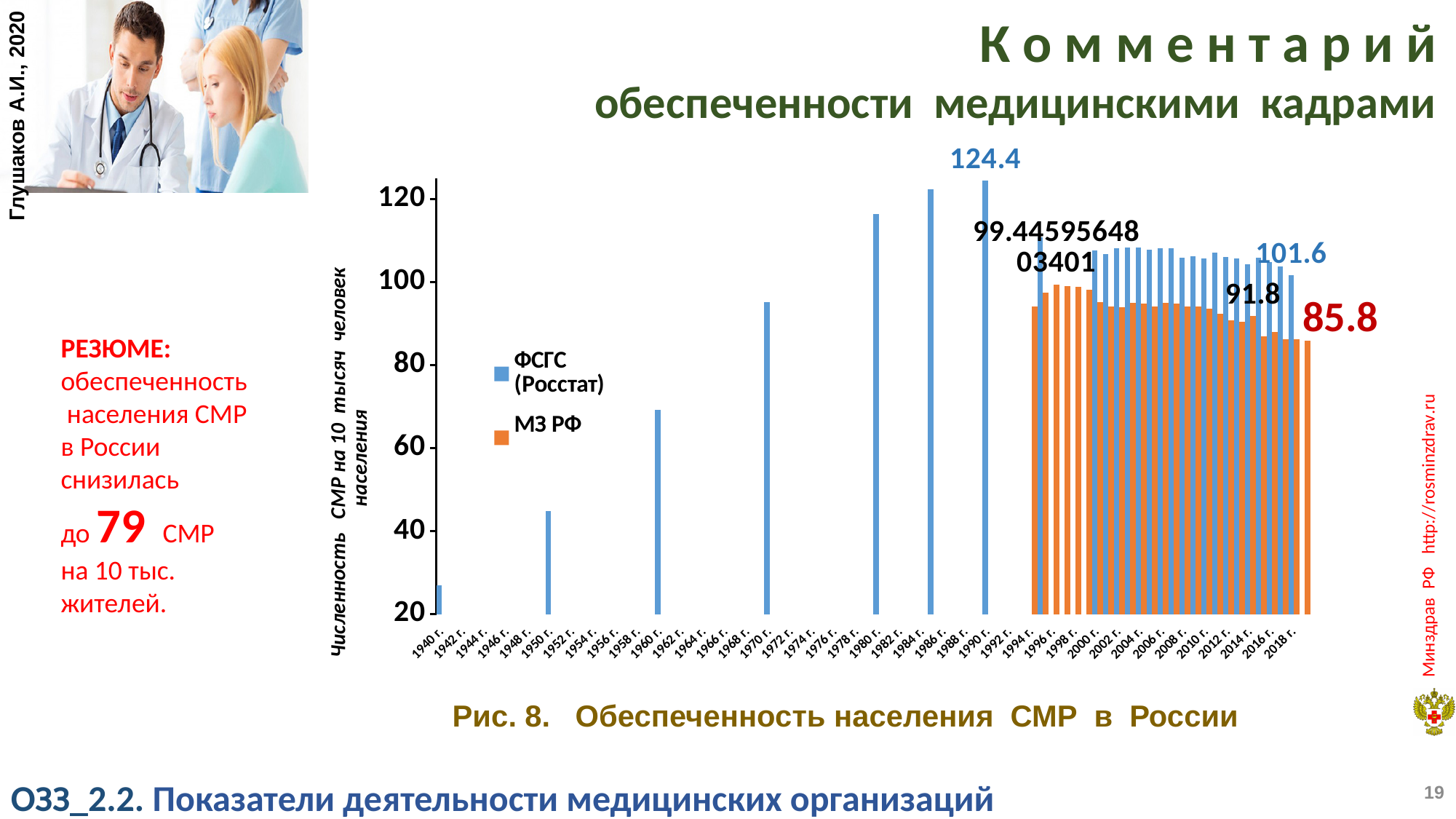
What is the value labelled in red on the last МЗ РФ bar at the right end of the chart? 85.8 Which year has the larger ФСГС (Росстат) value, 1960 or 1970? 1970 What is the caption of the chart (Рис. 8)? Обеспеченность населения СМР в России Is the ФСГС (Росстат) value for 1980 greater or less than 100? greater What is the highest value labelled on the chart, and in which year does it occur? 124.4 in 1990 What are the two series named in the chart legend? ФСГС (Росстат) and МЗ РФ Do the ФСГС (Росстат) values rise or fall from 1940 to 1990? rise What is the last value labelled in blue for the ФСГС (Росстат) series near the right end of the chart? 101.6 Is the ФСГС (Росстат) value for 1940 greater or less than 40? less How many series does the chart legend list? 2 What kind of chart is shown on the slide? bar chart What is the difference between the labelled peak value 124.4 and the final labelled value 85.8? 38.6